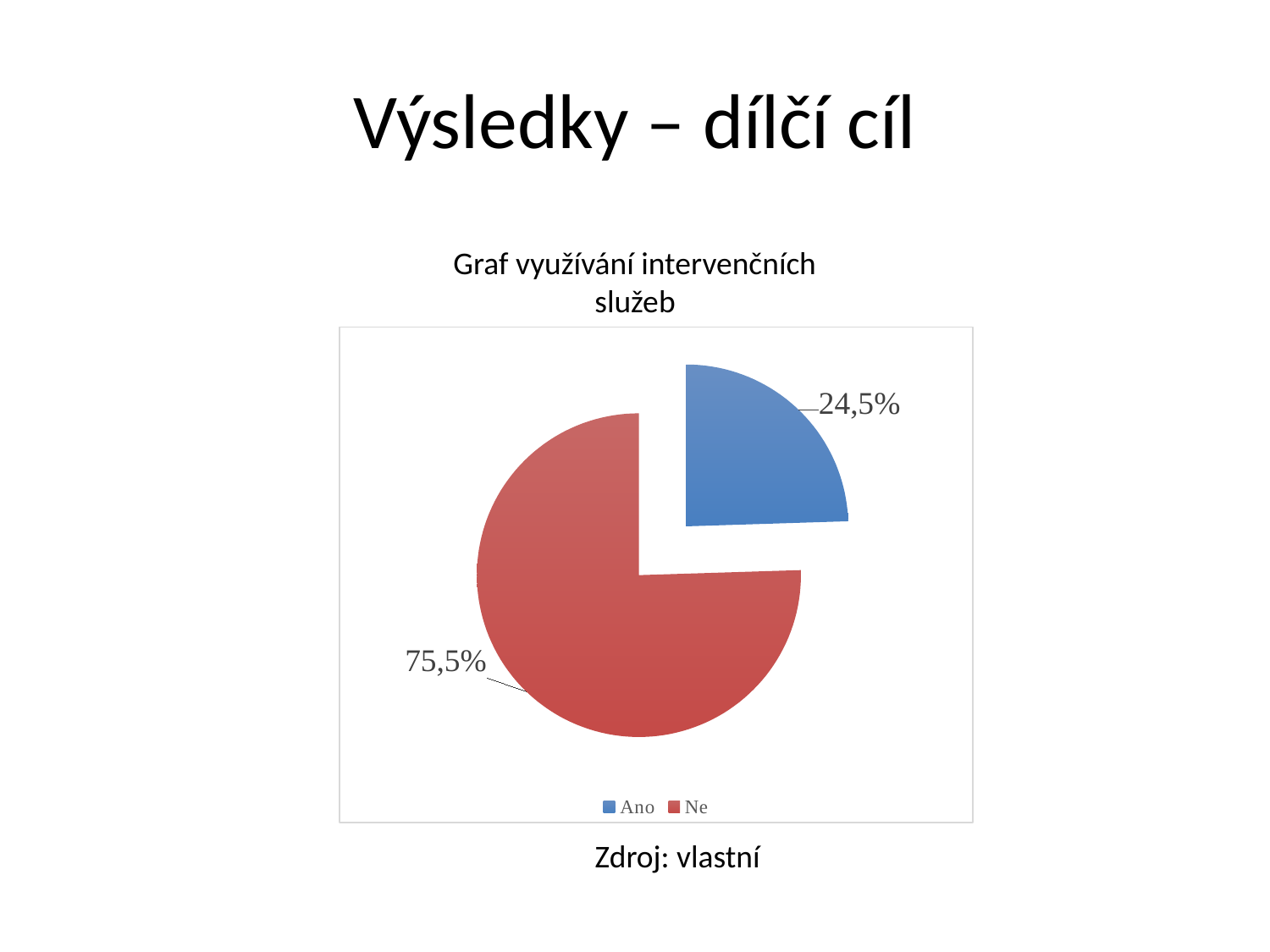
What kind of chart is shown on the slide? Pie chart What is the title of the chart? Graf využívání intervenčních služeb Which slice is larger, "Ano" or "Ne"? Ne Which category has the largest slice of the pie? Ne How many entries does the legend list? 2 What share of the pie does the "Ano" slice represent? 24,5% How many slices does the pie chart have? 2 What colour is the "Ano" slice? Blue What share of the pie does the "Ne" slice represent? 75,5% Which category has the smallest slice of the pie? Ano What is the difference in percentage points between the "Ne" and "Ano" slices? 51 percentage points